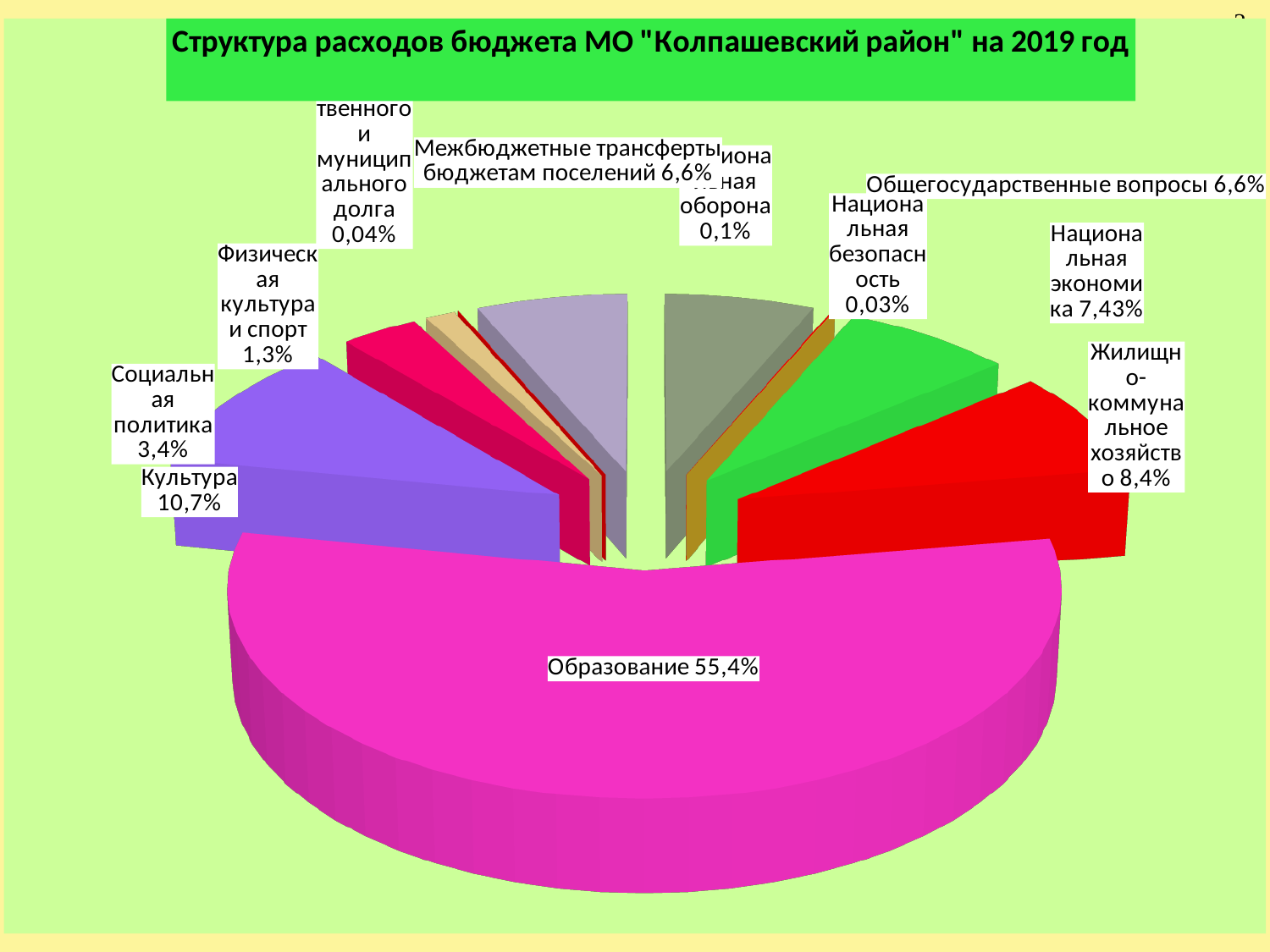
What is the value shown for Культура? 10,7% Which category has the largest share of the budget expenditures? Образование What is the difference between the shares of Культура and Жилищно-коммунальное хозяйство? 2,3% What is the value shown for Национальная экономика? 7,43% Which category has the smallest share of the budget expenditures? Национальная безопасность Which is larger: the share for Национальная экономика or the share for Общегосударственные вопросы? Национальная экономика What is the value shown for Национальная безопасность? 0,03% What is the value shown for Социальная политика? 3,4% What is the value shown for Жилищно-коммунальное хозяйство? 8,4% What share of the budget expenditures goes to Образование? 55,4% What is the title of the chart? Структура расходов бюджета МО "Колпашевский район" на 2019 год What type of chart is shown on the slide? Pie chart